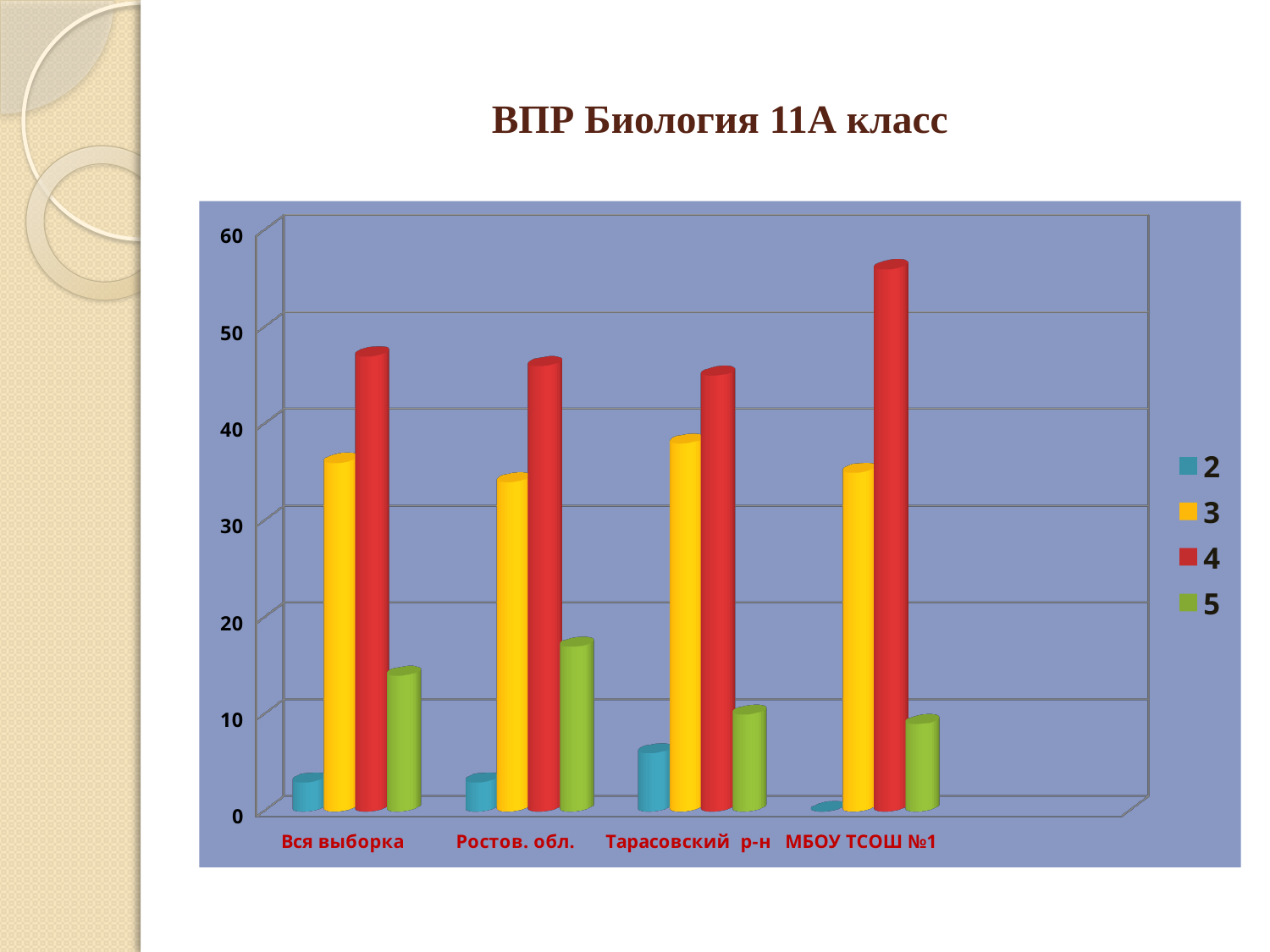
Is the value of series 5 for Тарасовский р-н greater or less than 20? less For which category is the value of series 2 the lowest? МБОУ ТСОШ №1 For Вся выборка, which is larger: the value of series 3 or the value of series 4? series 4 What is the title of the chart? ВПР Биология 11А класс Is the value of series 3 for Ростов. обл. greater or less than 40? less For which category is the value of series 4 the highest? МБОУ ТСОШ №1 Which colour represents series 4 in the legend? red For which category is the value of series 5 the highest? Ростов. обл. What kind of chart is shown on the slide? bar chart Is the value of series 4 for МБОУ ТСОШ №1 greater or less than 50? greater How many series does the legend list? 4 How many categories are shown along the x axis? 4